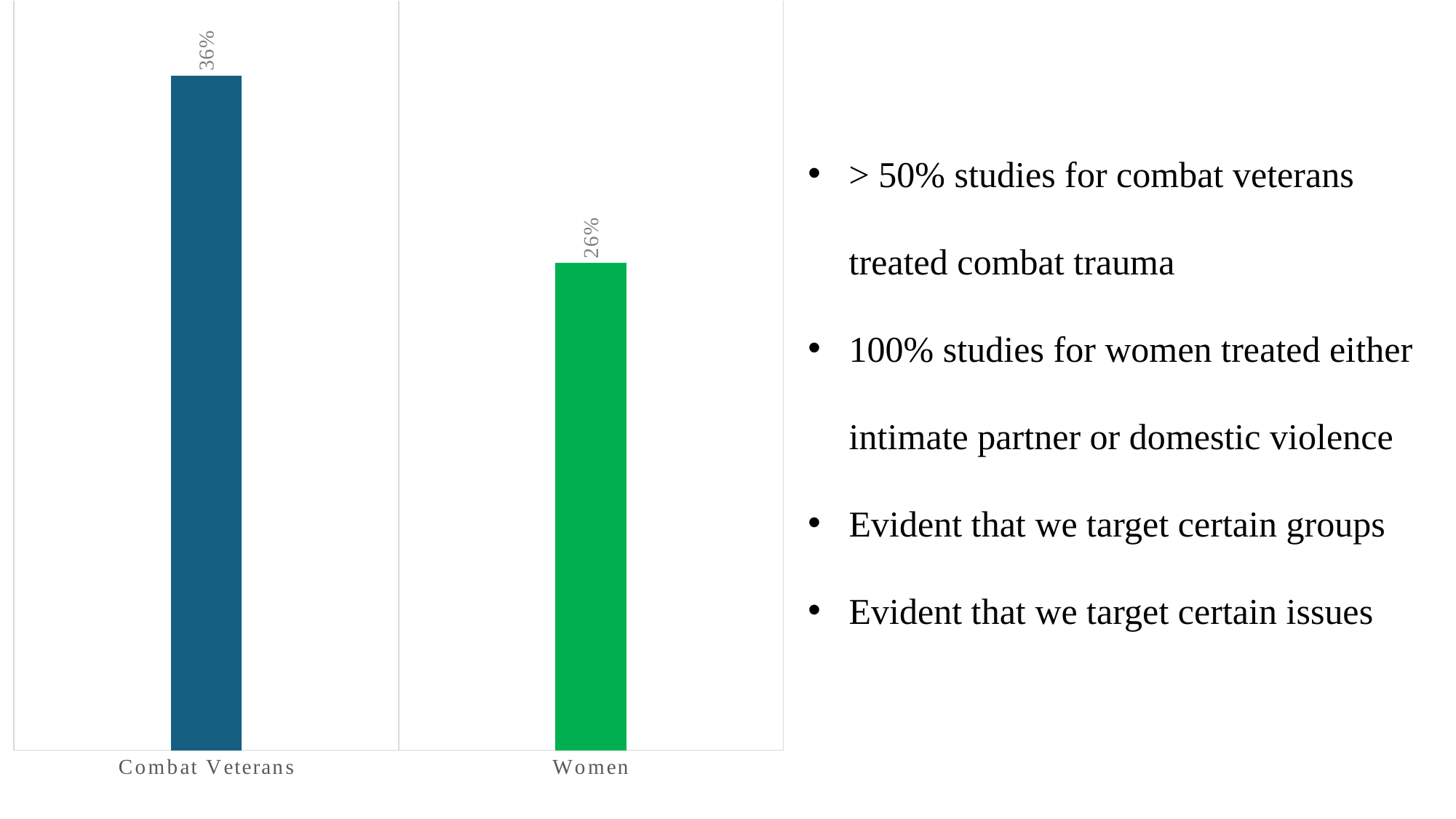
Which is larger, the value for Combat Veterans or the value for Women? Combat Veterans What kind of chart is shown on the slide? Bar chart How many categories are shown in the chart? 2 Which category has the lowest value? Women Which category has the highest value? Combat Veterans What colour is the bar for Women? Green What colour is the bar for Combat Veterans? Blue What is the difference between the values for Combat Veterans and Women? 10% What is the value for Women? 26% What is the value for Combat Veterans? 36%